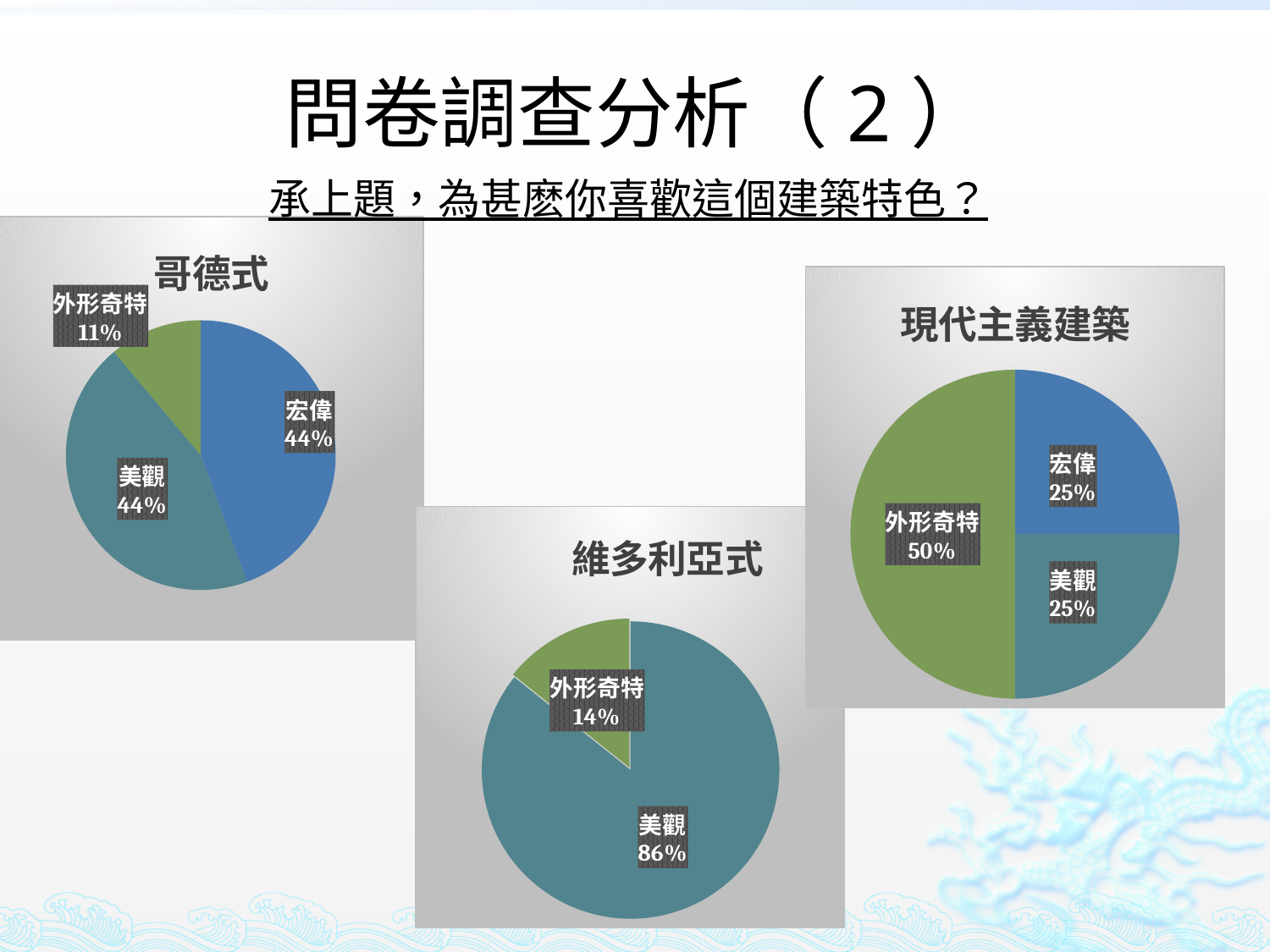
In the 維多利亞式 chart, what percentage is labelled for 美觀? 86% In the 現代主義建築 chart, which category has the largest slice? 外形奇特 In the 現代主義建築 chart, what percentage is labelled for 外形奇特? 50% How many slices does the 維多利亞式 pie chart have? 2 In the 維多利亞式 chart, what is the difference between the 美觀 and 外形奇特 percentages? 72% How many slices does the 哥德式 pie chart have? 3 In the 現代主義建築 chart, is the slice for 外形奇特 larger or smaller than the slice for 宏偉? larger In the 哥德式 chart, which category has the smallest slice? 外形奇特 In the 維多利亞式 chart, which category has the largest slice? 美觀 What type of chart is used for 現代主義建築? pie chart In the 哥德式 chart, what percentage is labelled for 外形奇特? 11% In the 哥德式 chart, what percentage is labelled for 宏偉? 44%